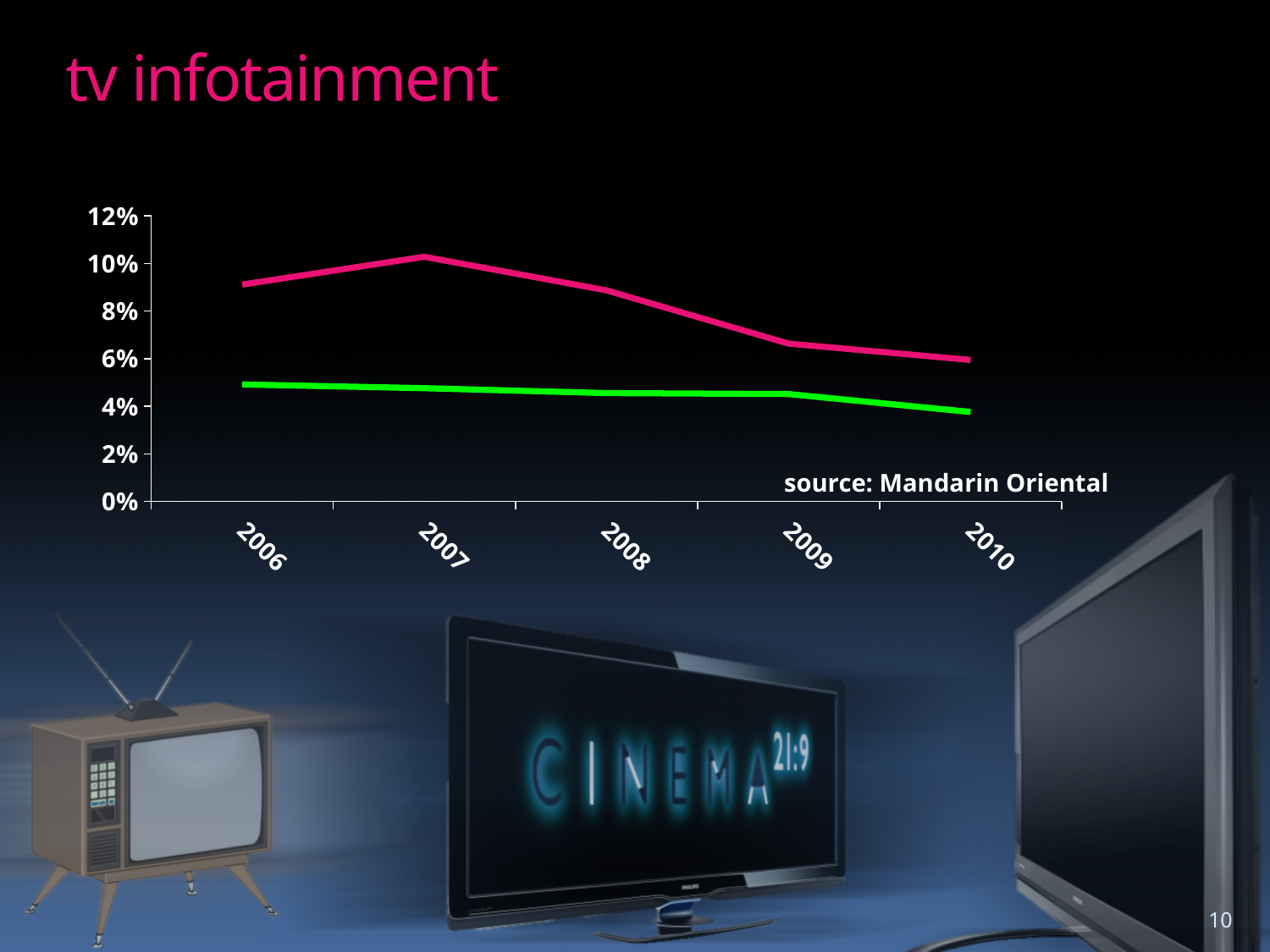
Is the value of the pink line in 2007 greater or less than 8%? greater How many lines are plotted on the chart? 2 In which year does the green line reach its lowest value? 2010 Does the pink line rise or fall from 2007 to 2010? fall In which year does the pink line reach its highest value? 2007 Which line has the higher value in 2008, the pink line or the green line? the pink line What source is cited on the chart? Mandarin Oriental Is the value of the green line in 2006 greater or less than 4%? greater How many years are shown on the x axis of the chart? 5 Is the value of the pink line in 2009 greater or less than 8%? less What kind of chart is shown on the slide? line chart